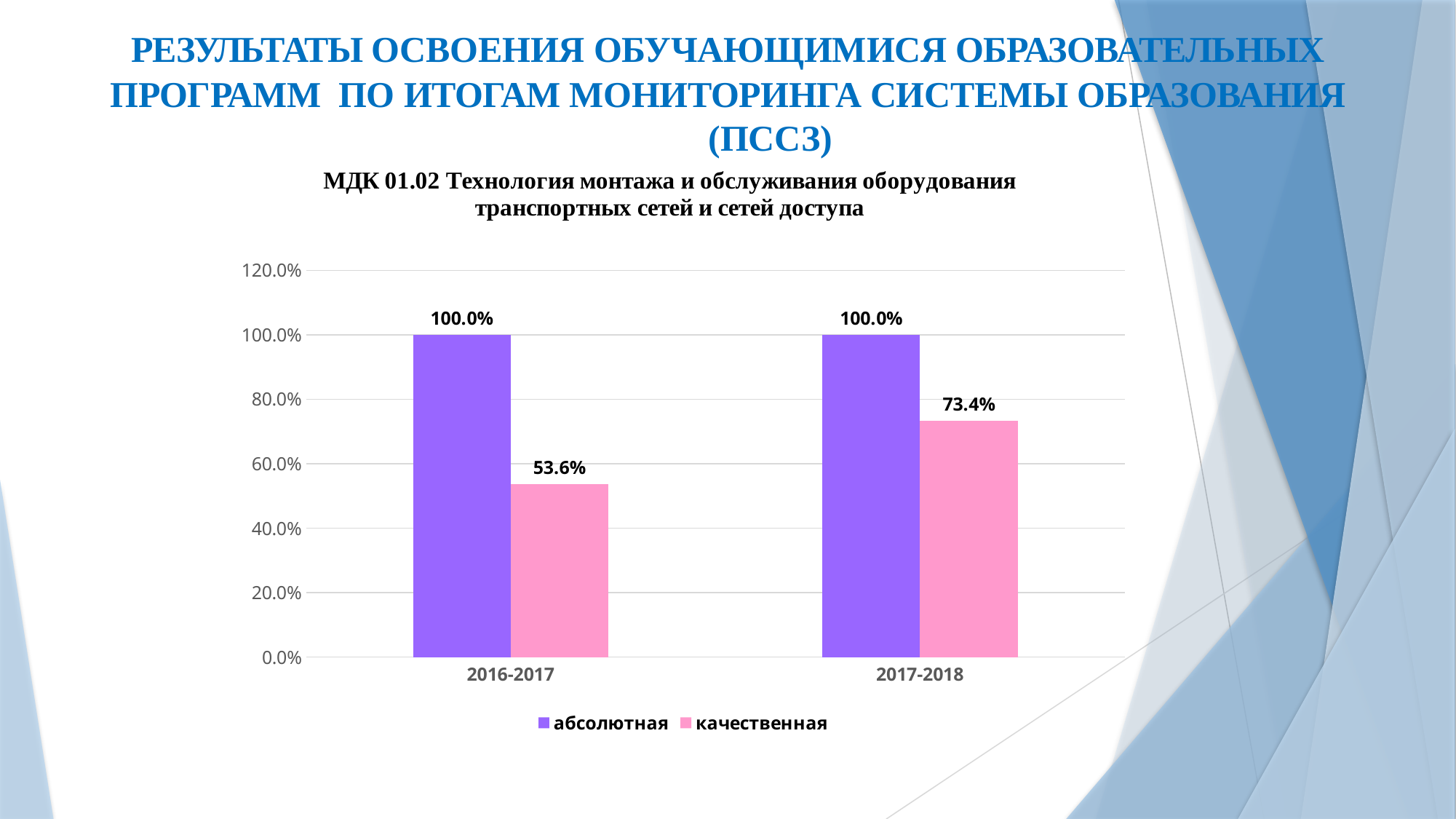
How many year categories are shown on the x axis? 2 What is the value of качественная for 2016-2017? 53.6% How many series does the legend list? 2 Does the качественная value rise or fall from 2016-2017 to 2017-2018? rise In which year is the качественная value lowest? 2016-2017 Which is larger for 2016-2017: абсолютная or качественная? абсолютная What is the value of абсолютная for 2016-2017? 100.0% In which year is the качественная value highest? 2017-2018 What kind of chart is shown on the slide? bar chart What is the value of абсолютная for 2017-2018? 100.0% What is the value of качественная for 2017-2018? 73.4% What is the difference between the качественная values for 2017-2018 and 2016-2017? 19.8%